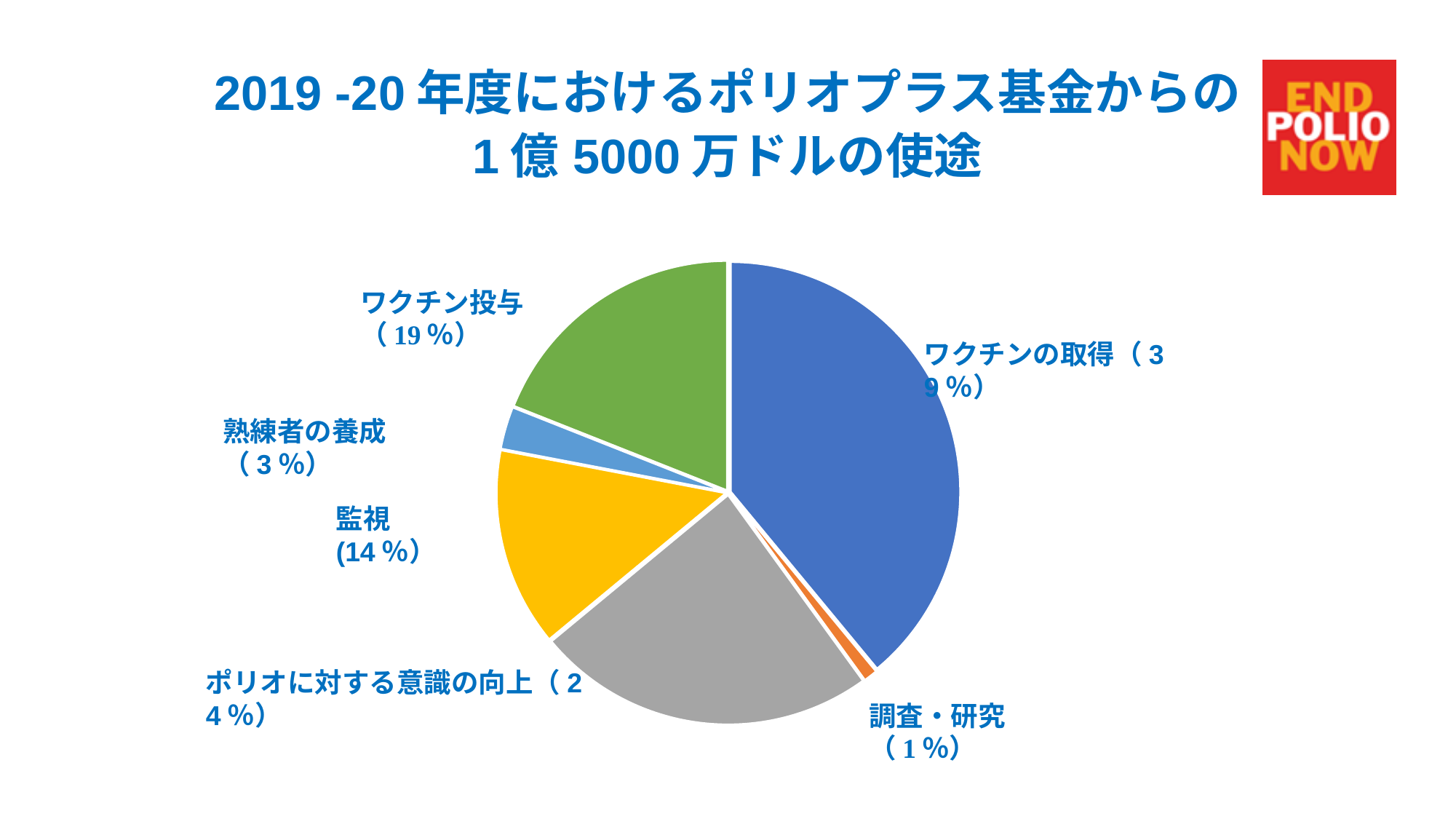
What share of the fund goes to 監視? 14% What is the combined share of ワクチン投与 and 熟練者の養成? 22% What colour is the slice for ポリオに対する意識の向上? grey What is the difference in percentage points between ワクチンの取得 and ワクチン投与? 20 What share of the fund goes to 調査・研究? 1% What share of the fund goes to ポリオに対する意識の向上? 24% What share of the fund goes to ワクチンの取得? 39% How many categories does the pie chart show? 6 Which category has the largest share of the pie? ワクチンの取得 What kind of chart is shown on the slide? pie chart Which category has the smallest share of the pie? 調査・研究 Which is larger, the share for 監視 or the share for 熟練者の養成? 監視